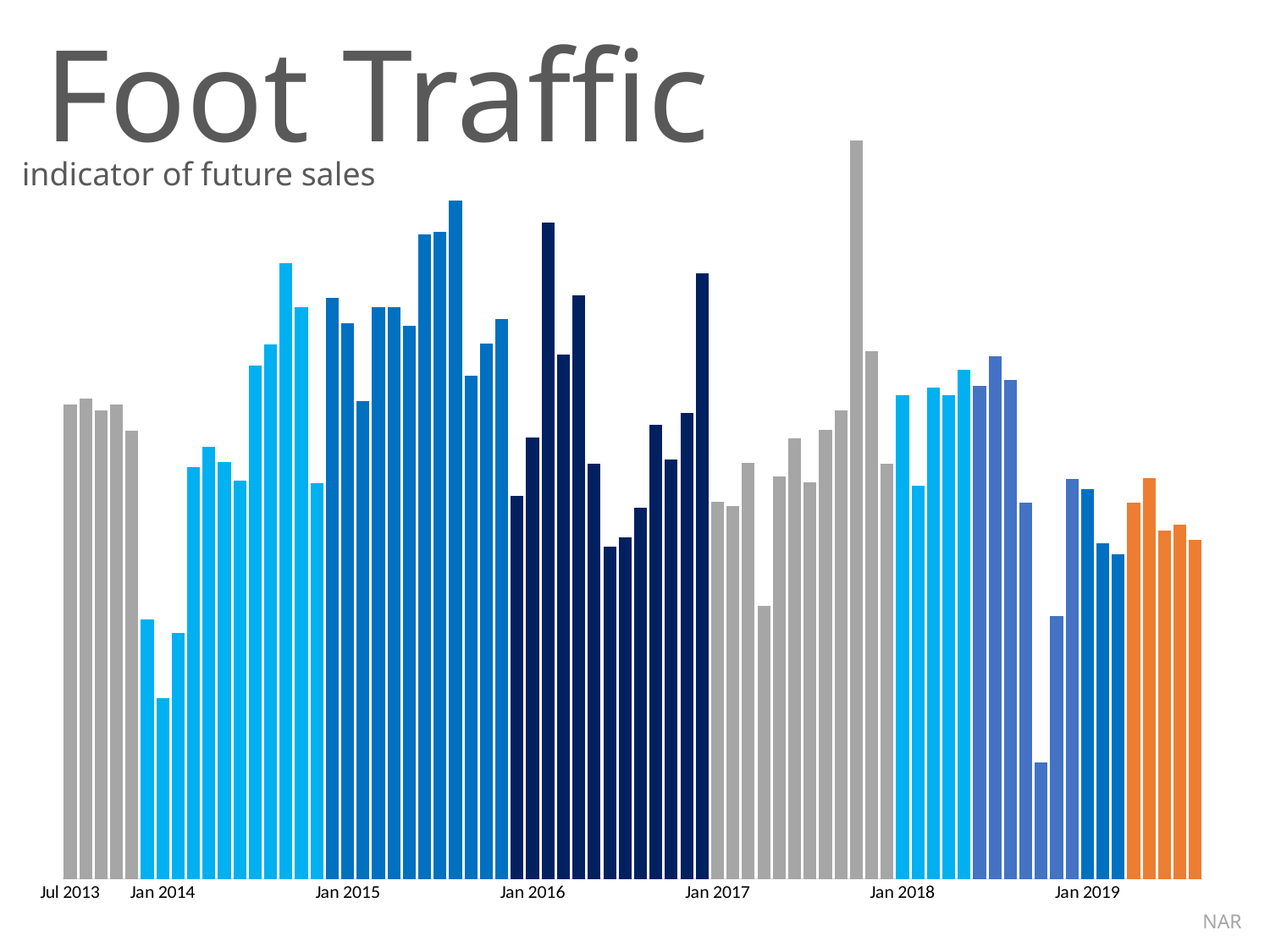
What source is credited in the bottom right corner of the slide? NAR Between which two x-axis labels does the tallest bar of the chart appear? Jan 2017 and Jan 2018 What is the title of the chart? Foot Traffic Between which two x-axis labels does the shortest bar of the chart appear? Jan 2018 and Jan 2019 How many date labels are shown along the x axis? 7 What kind of chart is shown on the slide? bar chart Is the bar at Jan 2014 taller or shorter than the bar at Jan 2015? shorter What is the first date label on the x axis? Jul 2013 Is the tallest bar between Jan 2015 and Jan 2016 taller or shorter than the tallest bar between Jan 2016 and Jan 2017? taller What subtitle appears under the chart title? indicator of future sales What is the last date label on the x axis? Jan 2019